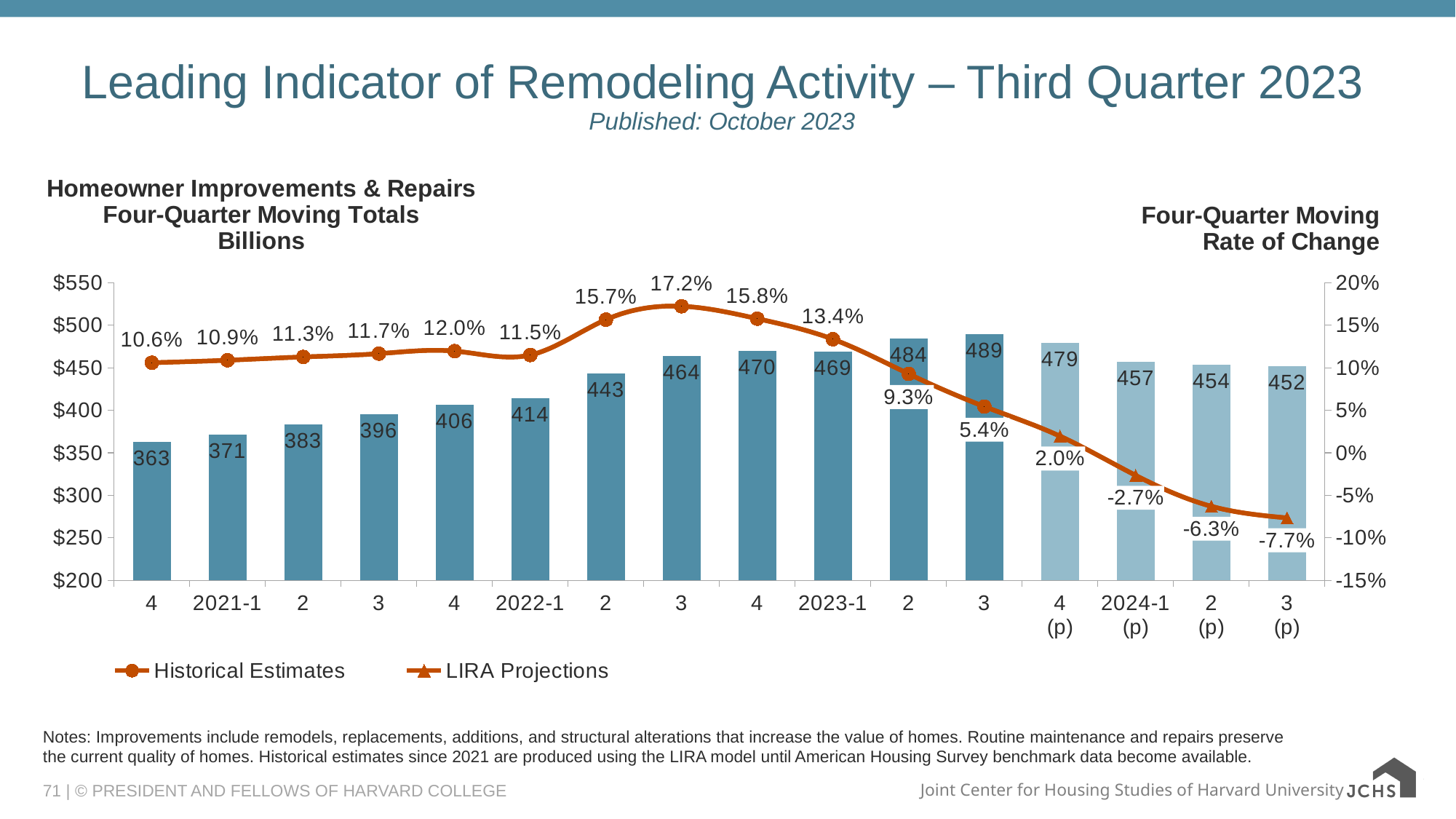
After peaking in the third quarter of 2022, does the four-quarter moving rate of change rise or fall through 2024-3 (p)? It falls What is the four-quarter moving total (in billions) shown for 2023-1? 469 What is the projected rate of change for 2024-1 (p)? -2.7% What four-quarter moving rate of change is shown for the third quarter of 2022? 17.2% By how many percentage points does the peak rate of change (17.2%) exceed the first value shown (10.6%)? 6.6 percentage points How many quarters (bars) are plotted on the chart? 16 What is the difference between the highest bar (489) and the lowest bar (363)? 126 Which quarter has the highest four-quarter moving total bar? 2023 quarter 3 (489) Which quarter has the lowest four-quarter moving rate of change? 2024 quarter 3 (p), at -7.7% How many series does the legend list? 2 What kind of chart is this? A combination bar and line chart Which is larger, the four-quarter moving total for 2022-2 or for 2024-1 (p)? 2024-1 (p), 457 vs 443